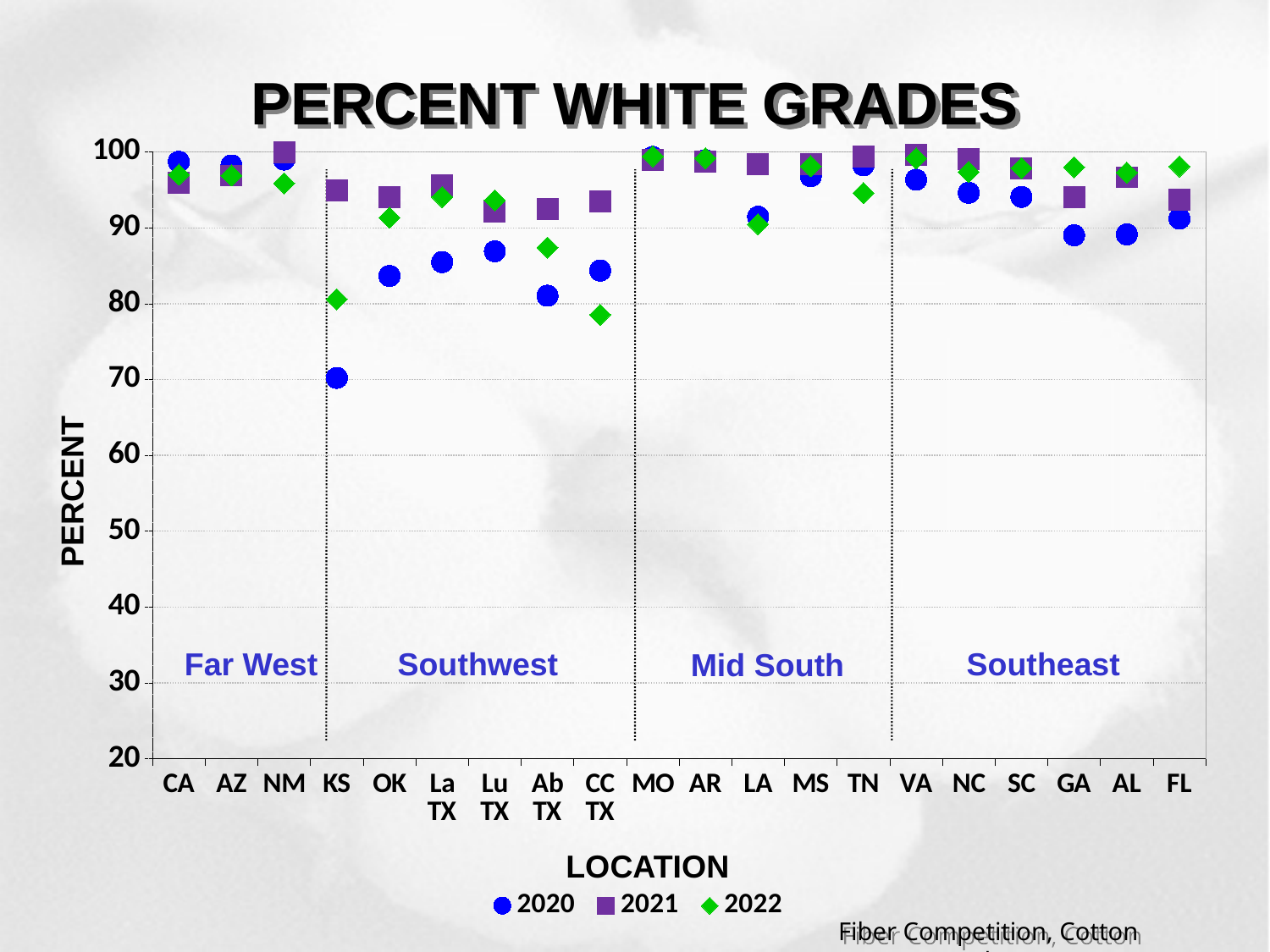
Is the 2022 value for CC TX greater or less than 80? less At KS, which series has the larger value, 2020 or 2021? 2021 What is the title of the chart? PERCENT WHITE GRADES At OK, which series has the larger value, 2020 or 2022? 2022 Is the 2021 value for KS greater or less than 90? greater What kind of chart is this? scatter chart How many series does the legend list? 3 How many locations are shown on the x axis? 20 What are the four region labels shown inside the plot area? Far West, Southwest, Mid South, Southeast Which location has the lowest value for the 2020 series? KS Which location has the lowest value for the 2022 series? CC TX Is the 2020 value for KS greater or less than 80? less